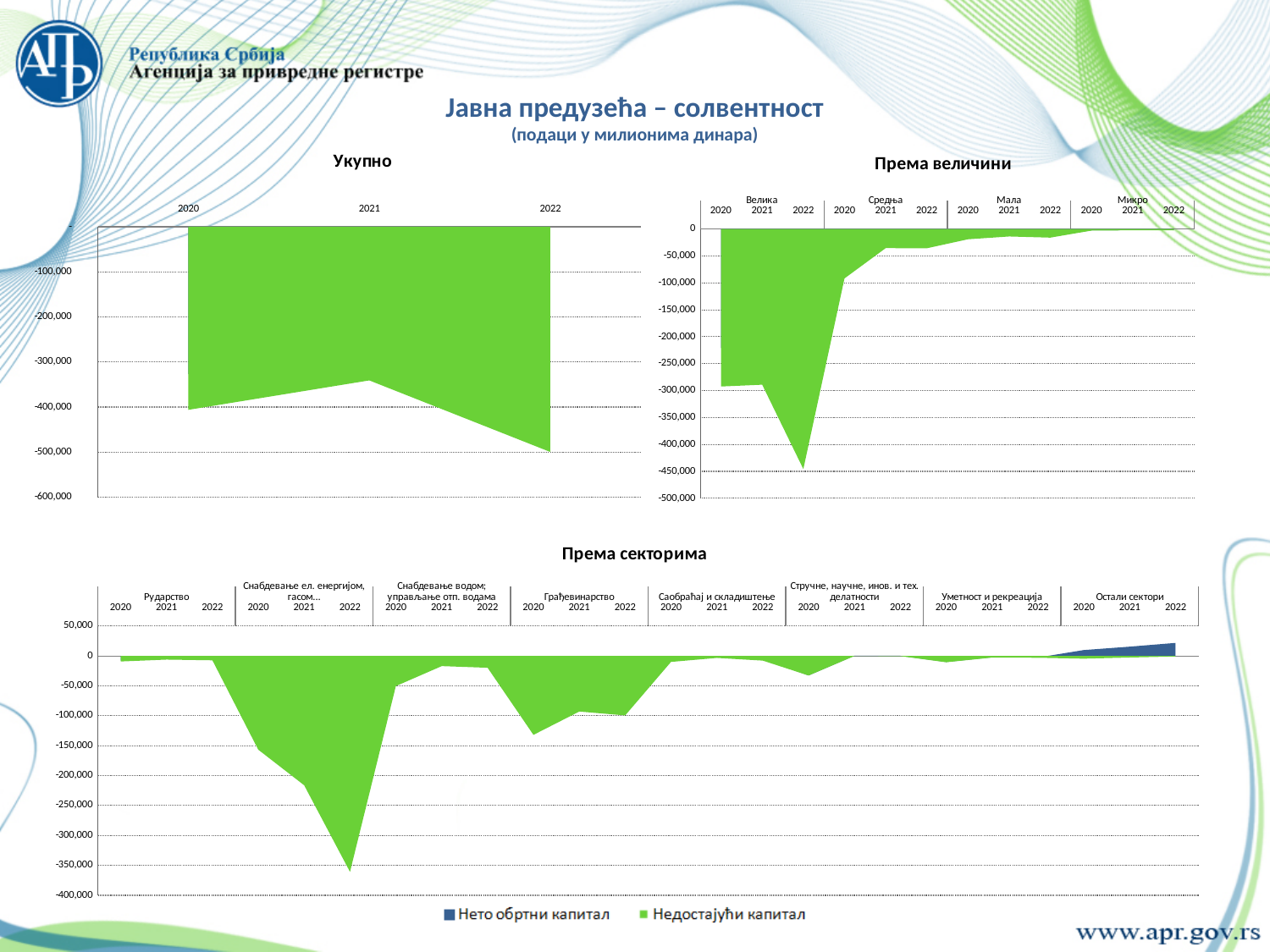
In the 'Према секторима' chart, is the value for 'Снабдевање ел. енергијом, гасом...' in 2022 greater or less than -300,000? less In the 'Према величини' chart, which size category and year has the lowest (most negative) value? Велика, 2022 In the 'Укупно' chart, is the value for 2022 greater or less than -400,000? less How many series does the legend of the 'Према секторима' chart list? 2 In the 'Укупно' chart, is the value for 2021 greater or less than -400,000? greater In the 'Према величини' chart, do the values for Средња rise or fall from 2020 to 2022? rise What type of chart is the 'Укупно' chart? area chart How many size categories are shown in the 'Према величини' chart? 4 In the 'Укупно' chart, which year has the lowest (most negative) value? 2022 In the 'Укупно' chart, which year has the highest (least negative) value? 2021